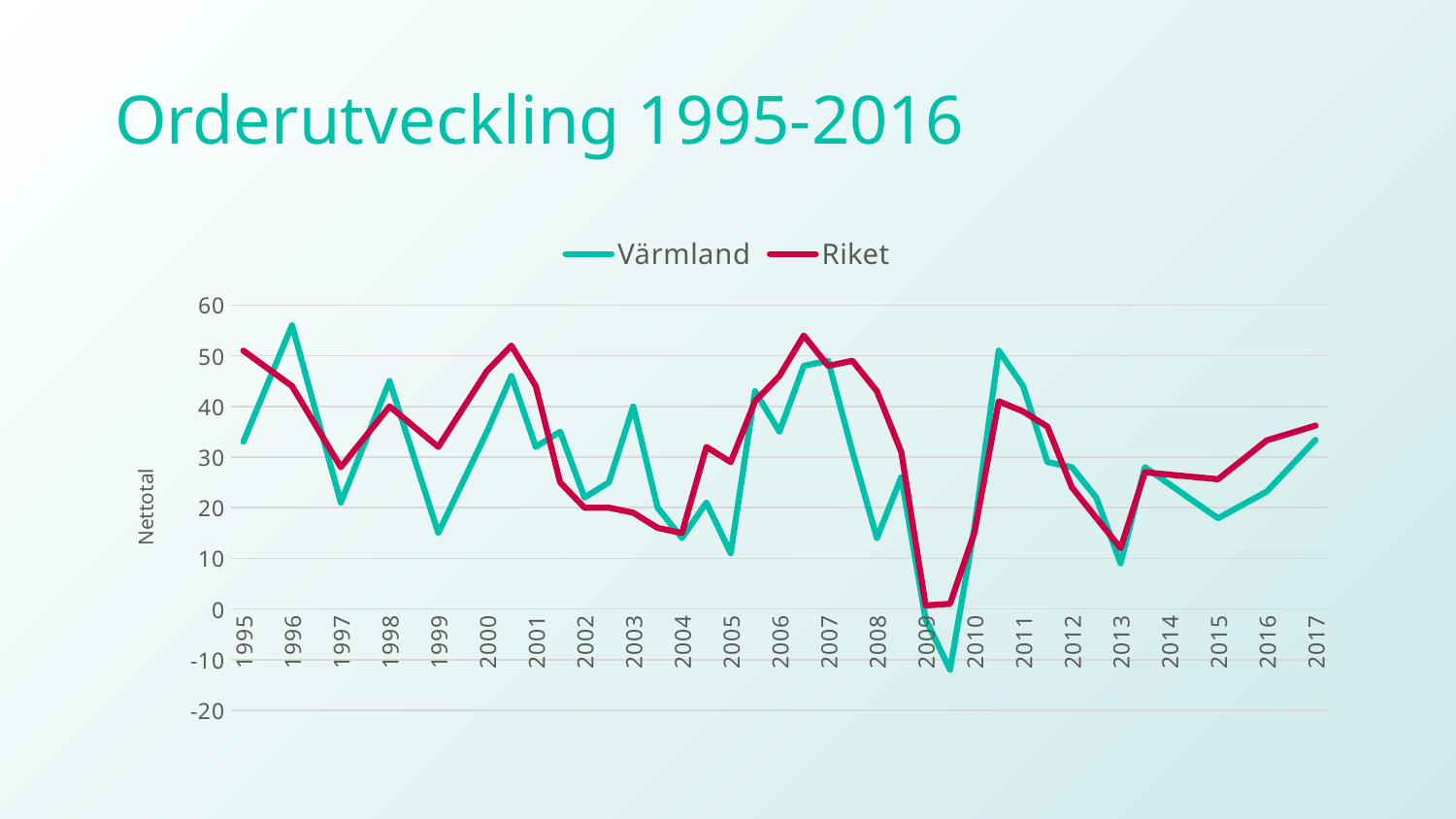
What is the title of the chart? Orderutveckling 1995-2016 Is the value for Värmland in 1996 greater or less than 50? greater Is the value for Värmland in 1999 greater or less than 20? less Is the lowest value for Värmland greater or less than 0? less In 1999, which series has the higher value, Värmland or Riket? Riket In which year does the Värmland series reach its lowest value? 2009 How many series does the legend list? 2 What is the label on the vertical axis? Nettotal In 1996, which series has the higher value, Värmland or Riket? Värmland What kind of chart is shown on the slide? line chart